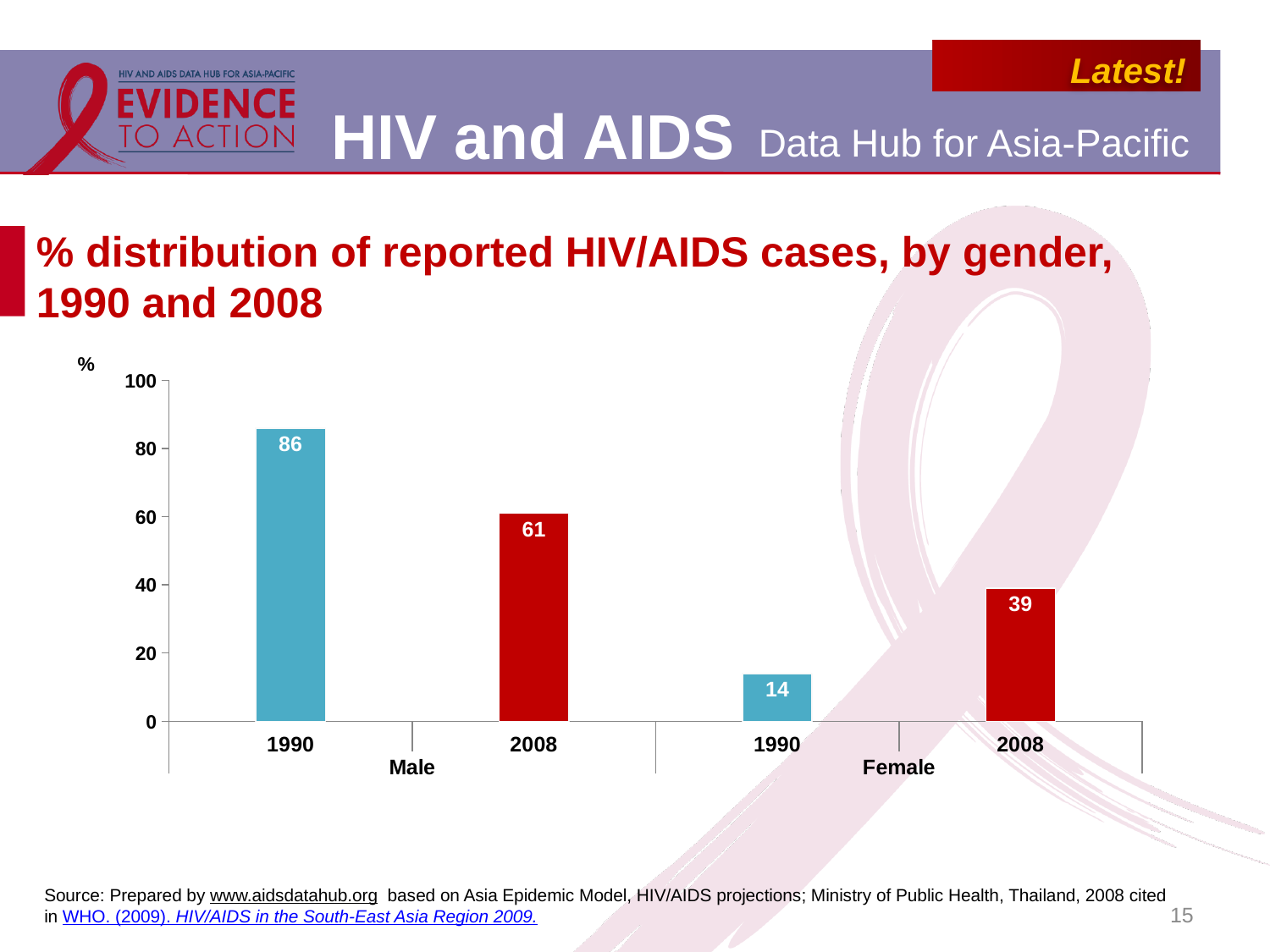
What is the value for Female in 2008? 39 What is the value for Male in 1990? 86 Which is larger, the Male value in 2008 or the Female value in 2008? Male 2008 How many bars are plotted in the chart? 4 What kind of chart is shown on the slide? Bar chart What is the value for Male in 2008? 61 Which bar has the lowest value? Female 1990 What is the value for Female in 1990? 14 What is the difference between the Female values for 2008 and 1990? 25 What is the title of the chart? % distribution of reported HIV/AIDS cases, by gender, 1990 and 2008 Which bar has the highest value? Male 1990 What is the difference between the Male values for 1990 and 2008? 25